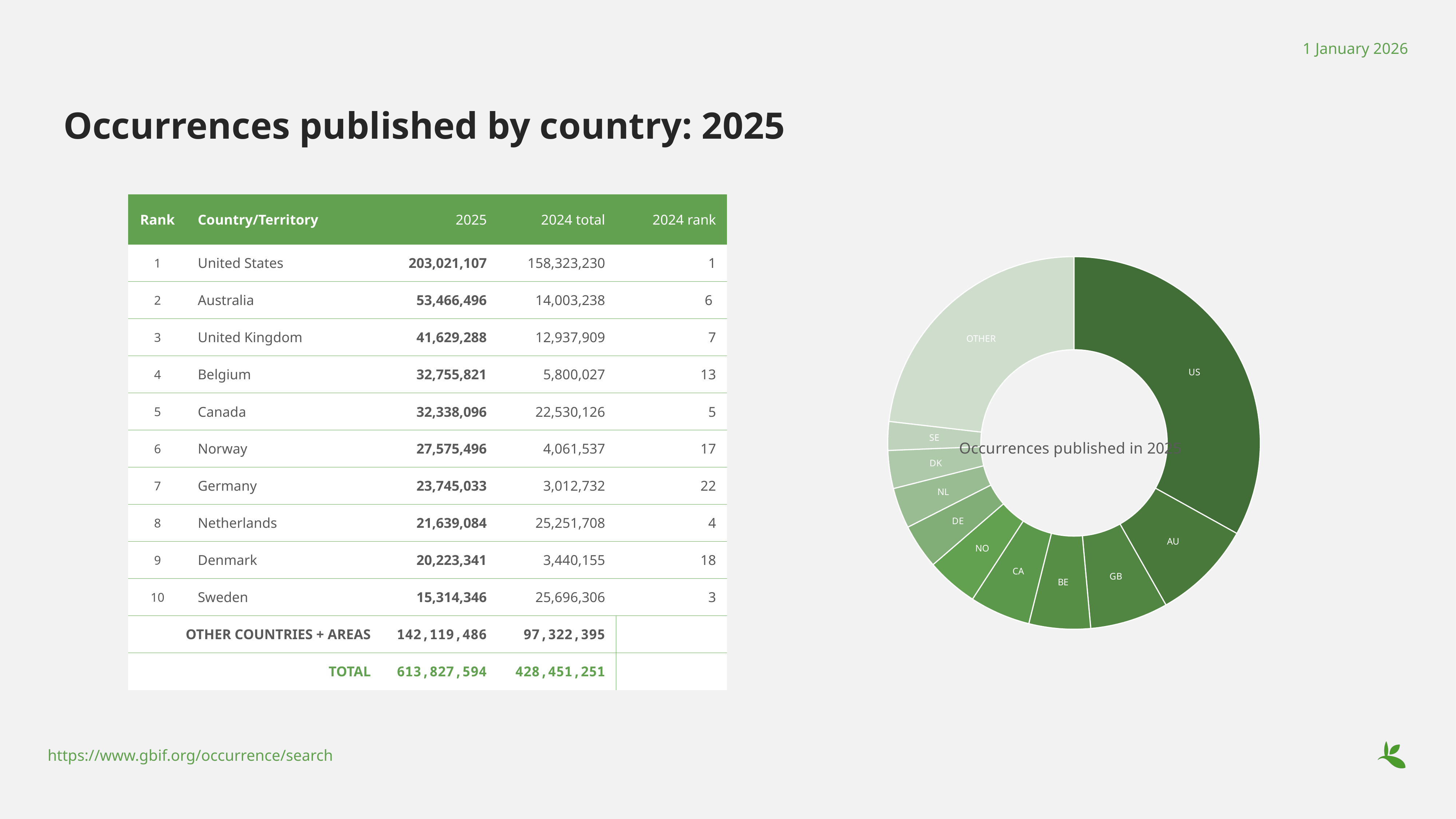
What kind of chart is shown on the right of the slide? pie chart (donut) What is the difference between the 2025 values for the US and AU slices? 149,554,611 What is the 2025 occurrence count for the AU (Australia) slice of the donut chart? 53,466,496 Which labelled country slice of the donut chart is the smallest? SE In the donut chart, which slice is larger, AU or BE? AU In the donut chart, which slice is larger, US or OTHER? US What is the 2025 occurrence count for the US slice of the donut chart? 203,021,107 How many slices does the donut chart have? 11 Which slice of the donut chart is drawn in the lightest shade of green? OTHER What is the total number of occurrences represented by the whole donut chart? 613,827,594 Which slice of the donut chart is the largest? US What text is written in the centre of the donut chart? Occurrences published in 2025